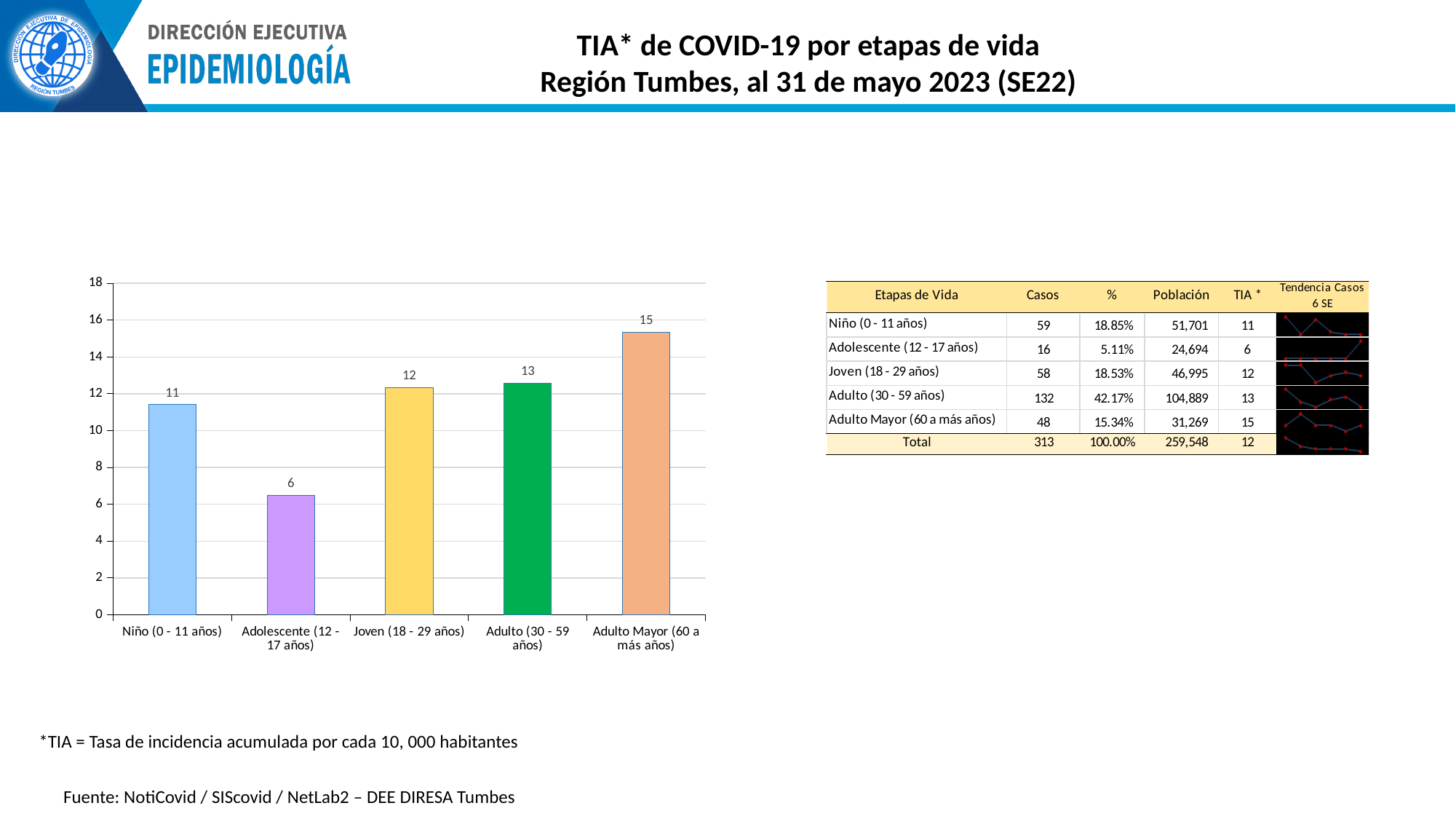
What is the TIA value shown for Adolescente (12 - 17 años) in the bar chart? 6 What is the TIA value shown for Adulto (30 - 59 años) in the bar chart? 13 What is the difference between the labelled values for Adulto Mayor (60 a más años) and Adolescente (12 - 17 años)? 9 Which has a larger value in the bar chart, Joven (18 - 29 años) or Niño (0 - 11 años)? Joven (18 - 29 años) What colour is the bar for Adulto (30 - 59 años)? Green What is the TIA value shown for Niño (0 - 11 años) in the bar chart? 11 What is the maximum value shown on the vertical axis of the bar chart? 18 How many life-stage categories are plotted in the bar chart? 5 Is the value for Adulto Mayor (60 a más años) greater or less than 14? greater Which life stage has the highest bar in the chart? Adulto Mayor (60 a más años) Which life stage has the lowest bar in the chart? Adolescente (12 - 17 años) What type of chart is used to show TIA by life stage? Bar chart